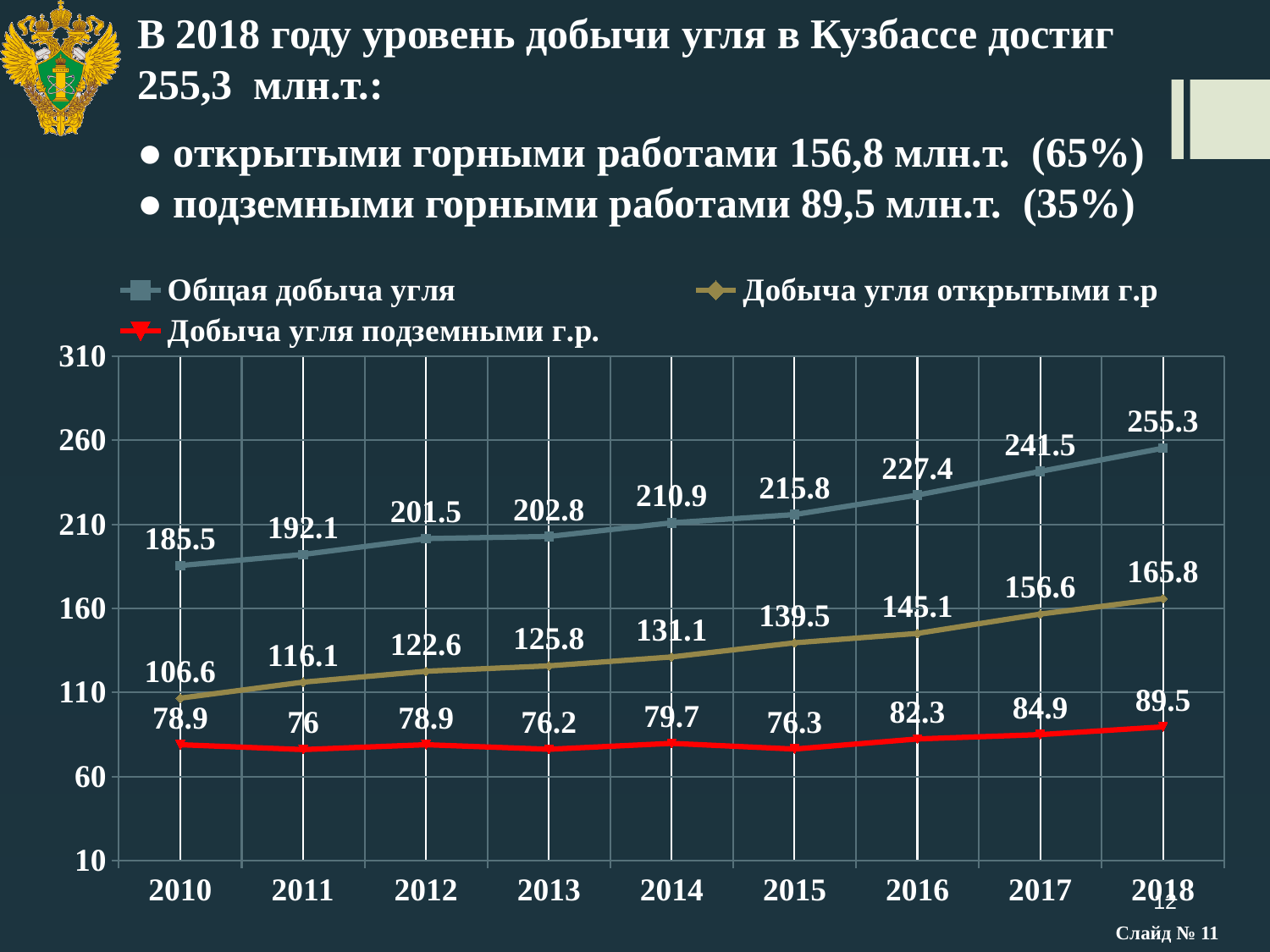
In which year is Общая добыча угля highest? 2018 Does Общая добыча угля rise or fall from 2010 to 2018? rise What is the difference between Общая добыча угля in 2018 and in 2010? 69.8 What is the value of Добыча угля открытыми г.р in 2014? 131.1 Which is larger: Добыча угля подземными г.р. in 2016 or in 2015? 2016 In which year is Добыча угля открытыми г.р lowest? 2010 How many years are plotted along the x axis of the chart? 9 What colour is the line for Добыча угля подземными г.р.? red How many series does the chart legend list? 3 What is the value of Добыча угля подземными г.р. in 2011? 76 What type of chart is shown on the slide? line chart What is the value of Общая добыча угля in 2018? 255.3